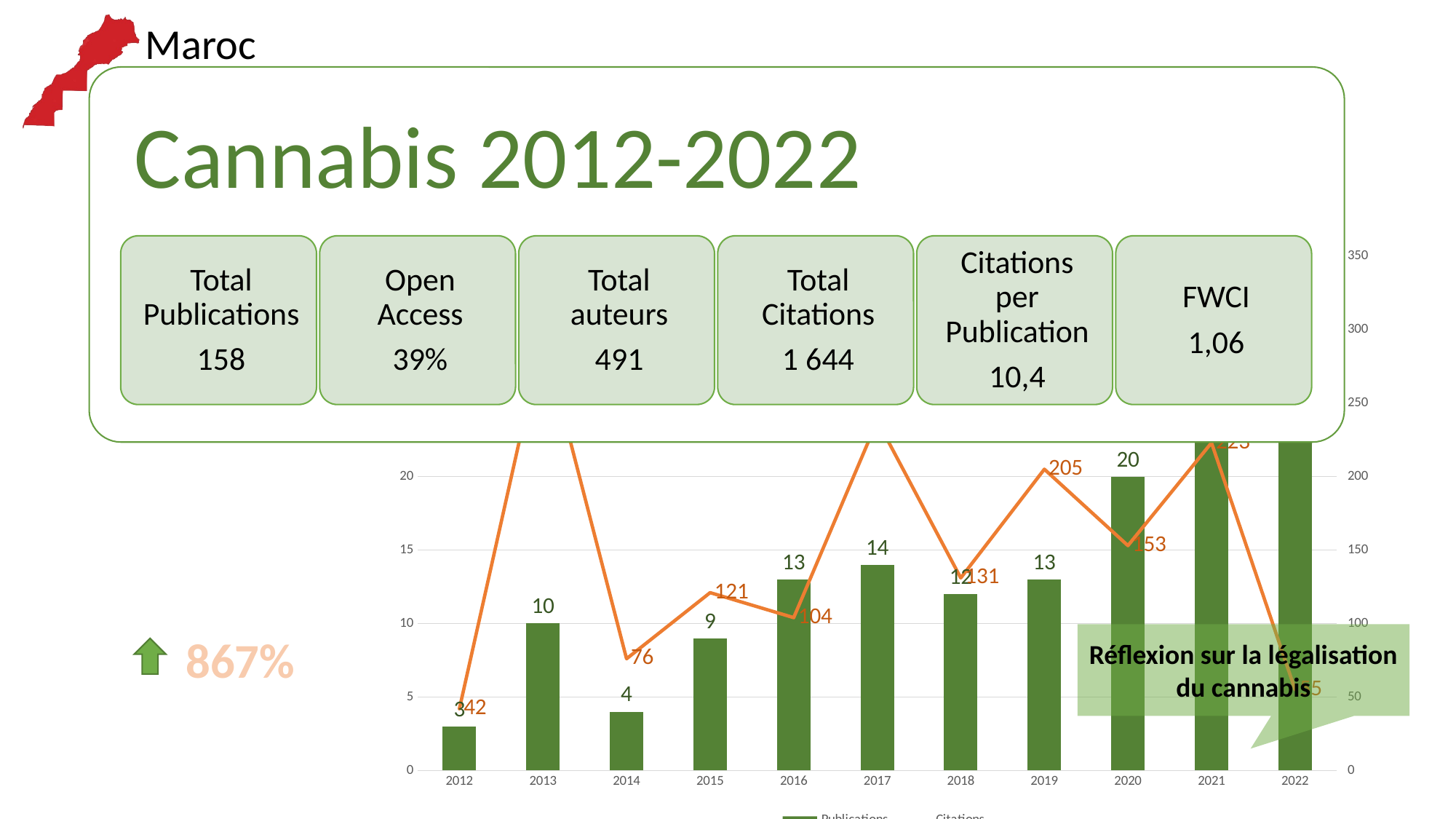
What is the number of publications in 2020? 20 How many years are shown on the x axis of the chart? 11 What is the difference in citations between 2019 and 2018? 74 Is the citations value for 2013 greater or less than 200? greater How many series does the chart's legend list? 2 What is the difference in publications between 2020 and 2012? 17 Which year has the lowest number of publications? 2012 What is the citations value for 2019? 205 How many publications are shown for 2013? 10 Which year has more publications, 2017 or 2015? 2017 What is the citations value for 2015? 121 What kind of chart is shown on the slide? A combined bar and line chart